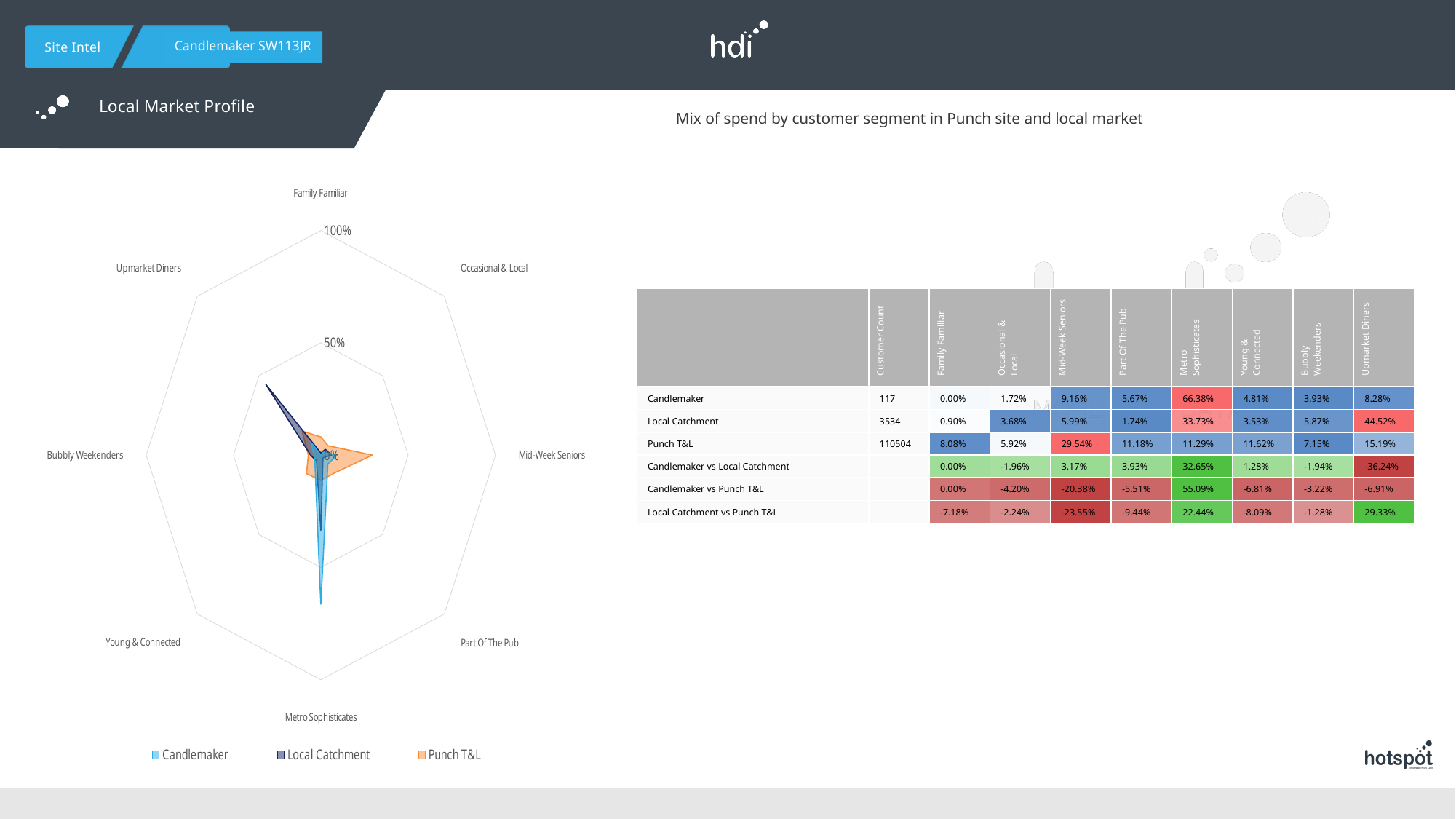
What kind of chart is shown on the left of the slide? Radar chart At Metro Sophisticates, which is larger: the Candlemaker value or the Punch T&L value? Candlemaker In the radar chart, is the Local Catchment value for Upmarket Diners greater or less than 50%? less In the radar chart, is the Candlemaker value for Metro Sophisticates greater or less than 50%? greater How many customer segments (axes) does the radar chart have? 8 How many series does the radar chart's legend list? 3 In the radar chart, is the Punch T&L value for Mid-Week Seniors greater or less than 50%? less What is the Candlemaker share of spend for Metro Sophisticates, as printed in the table? 66.38% Which series are listed in the radar chart's legend? Candlemaker, Local Catchment, Punch T&L For which segment does the Candlemaker series reach its highest value? Metro Sophisticates For which segment does the Punch T&L series reach its highest value? Mid-Week Seniors For which segment does the Local Catchment series reach its highest value? Upmarket Diners